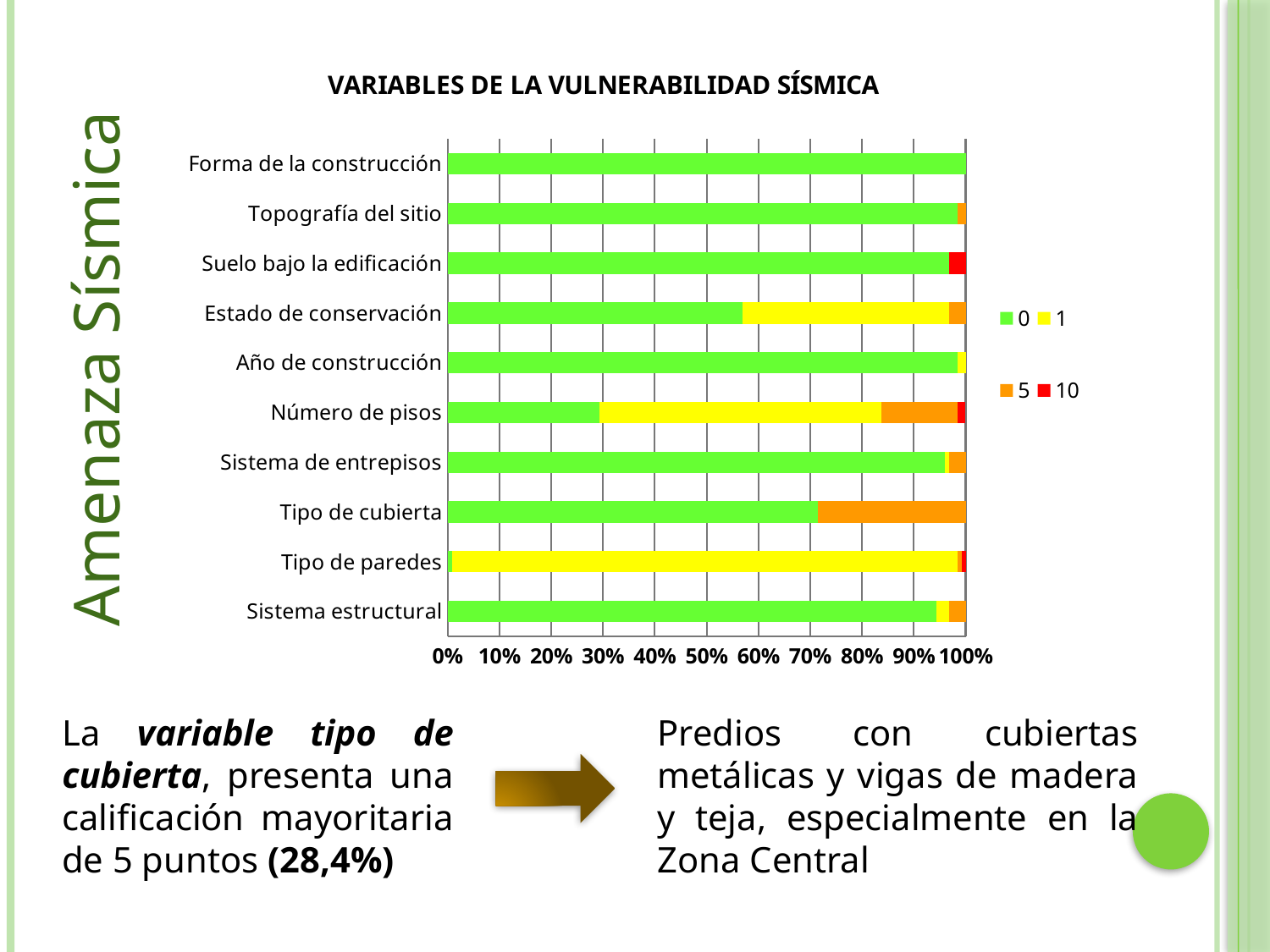
How many series does the chart legend list? 4 Is the share of score 0 for Tipo de cubierta greater or less than 60%? greater What kind of chart is shown on the slide? Stacked bar chart Which has a larger share of score 0: Forma de la construcción or Número de pisos? Forma de la construcción Which colour represents the score 10 in the chart legend? Red What is the title of the chart? VARIABLES DE LA VULNERABILIDAD SÍSMICA How many variables (categories) are plotted on the chart? 10 Is the share of score 1 for Tipo de paredes greater or less than 90%? greater Is the share of score 0 for Número de pisos greater or less than 40%? less Which variable has the largest share of score 1 (yellow)? Tipo de paredes Which variable has the largest share of score 5 (orange)? Tipo de cubierta